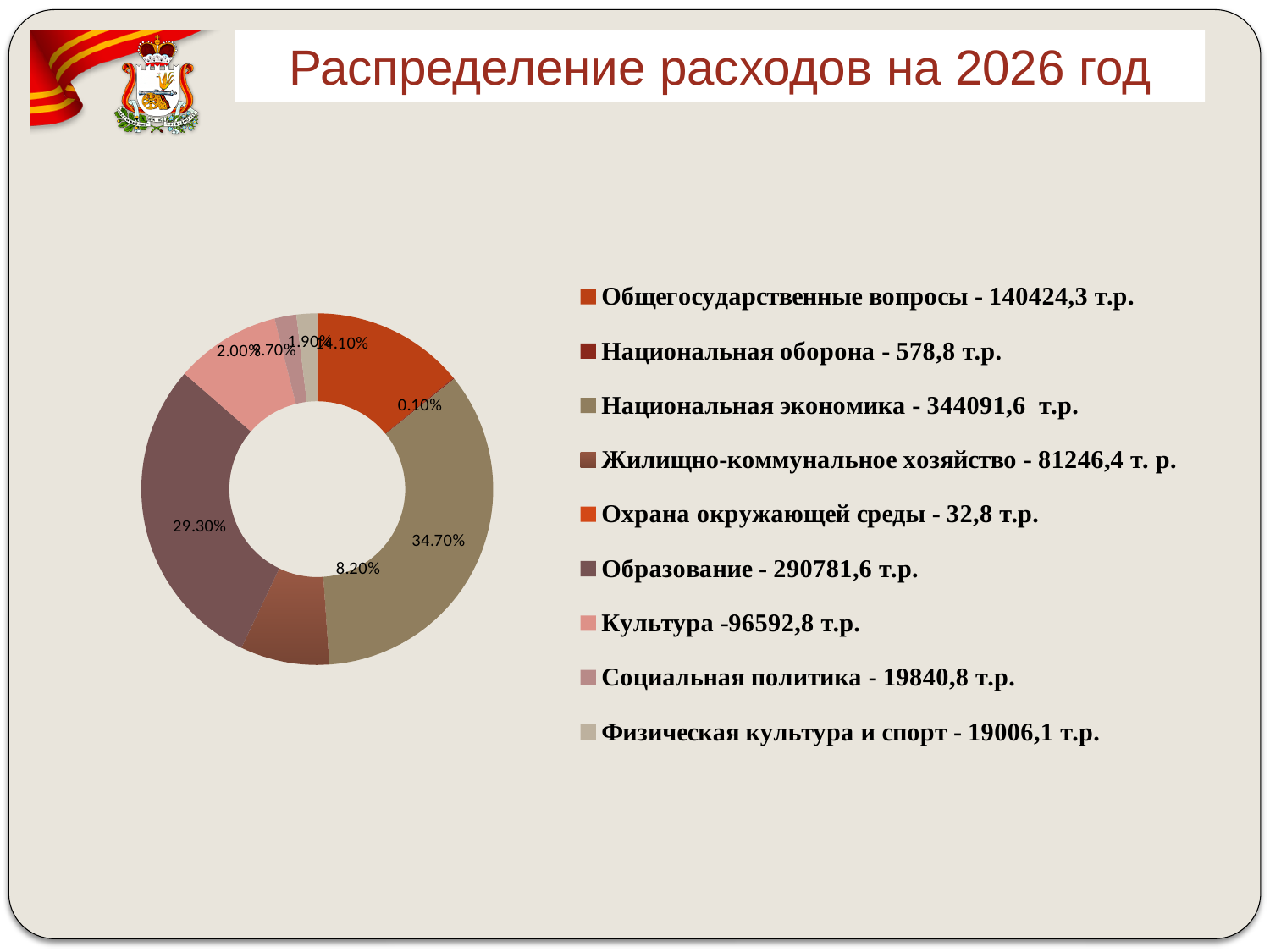
Which category has the largest share of the chart? Национальная экономика What share of the chart is labelled for Жилищно-коммунальное хозяйство? 8.20% What share of the chart is labelled for Общегосударственные вопросы? 14.10% What type of chart is shown on the slide? Doughnut (pie) chart What share of the chart is labelled for Образование? 29.30% What share of the chart is labelled for Культура? 9.70% Which has the larger share: Образование or Общегосударственные вопросы? Образование How many categories does the chart legend list? 9 According to the legend, what amount is given for Образование? 290781,6 т.р. What share of the chart is labelled for Национальная экономика? 34.70% What is the difference between the shares of Национальная экономика and Образование? 5.40% What is the title of the chart on the slide? Распределение расходов на 2026 год